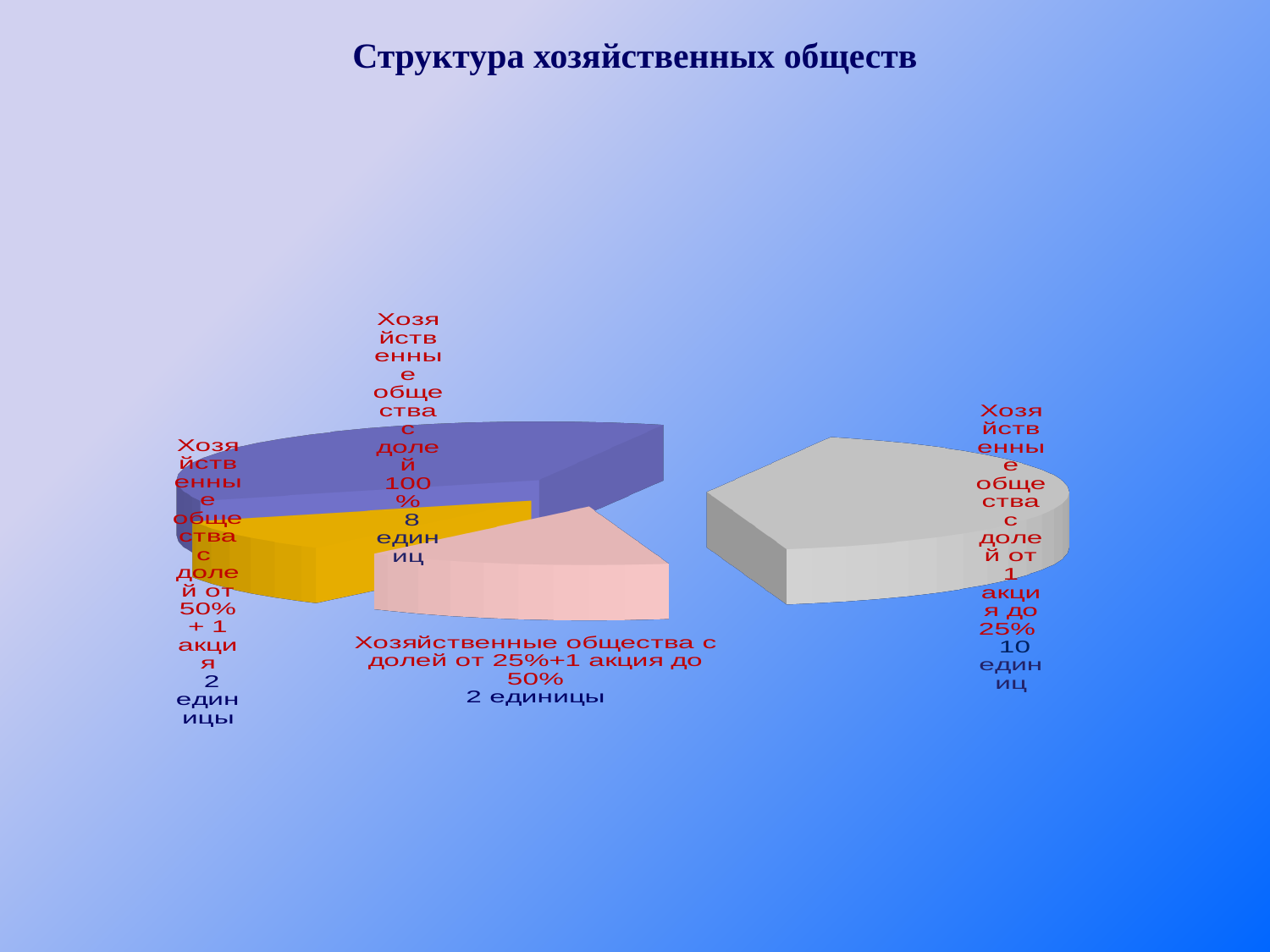
What colour is the slice for 'Хозяйственные общества с долей от 25%+1 акция до 50%'? pink How many units are shown for 'Хозяйственные общества с долей 100%'? 8 единиц What is the difference in units between 'Хозяйственные общества с долей от 1 акция до 25%' and 'Хозяйственные общества с долей 100%'? 2 How many units are shown for 'Хозяйственные общества с долей от 1 акция до 25%'? 10 единиц How many units are shown for 'Хозяйственные общества с долей от 25%+1 акция до 50%'? 2 единицы What is the total number of units across all slices of the pie? 22 What kind of chart is shown on the slide? pie chart What is the title of the chart? Структура хозяйственных обществ Which category has the largest slice of the pie? Хозяйственные общества с долей от 1 акция до 25% How many units are shown for 'Хозяйственные общества с долей от 50% + 1 акция'? 2 единицы How many slices does the pie chart have? 4 Which is larger: the value for 'Хозяйственные общества с долей 100%' or the value for 'Хозяйственные общества с долей от 50% + 1 акция'? Хозяйственные общества с долей 100%